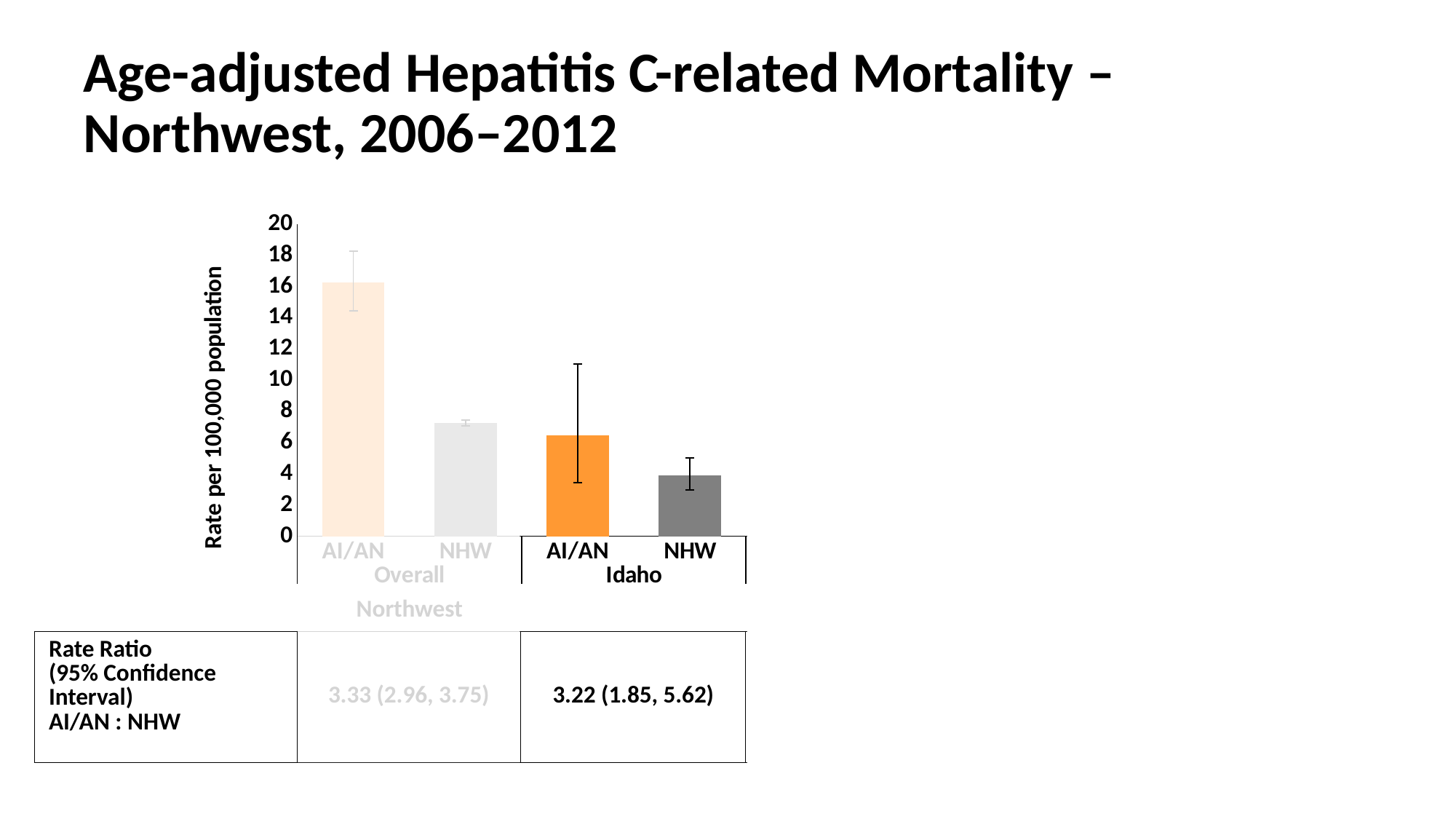
Which is larger, the NHW bar for Overall Northwest or the AI/AN bar for Idaho? NHW (Overall Northwest) What is the label on the y axis of the chart? Rate per 100,000 population What is the rate ratio (95% confidence interval) AI/AN : NHW shown for Idaho? 3.22 (1.85, 5.62) Which bar has the lowest value in the chart? NHW (Idaho) Is the value for NHW in the Overall Northwest group greater or less than 8? less How many bars are plotted in the chart? 4 Which is larger, the AI/AN bar for Idaho or the NHW bar for Idaho? AI/AN Is the value for AI/AN in Idaho greater or less than 6? greater Is the value for AI/AN in the Overall Northwest group greater or less than 14? greater Which bar has the highest value in the chart? AI/AN (Overall Northwest) What kind of chart is shown on the slide? bar chart